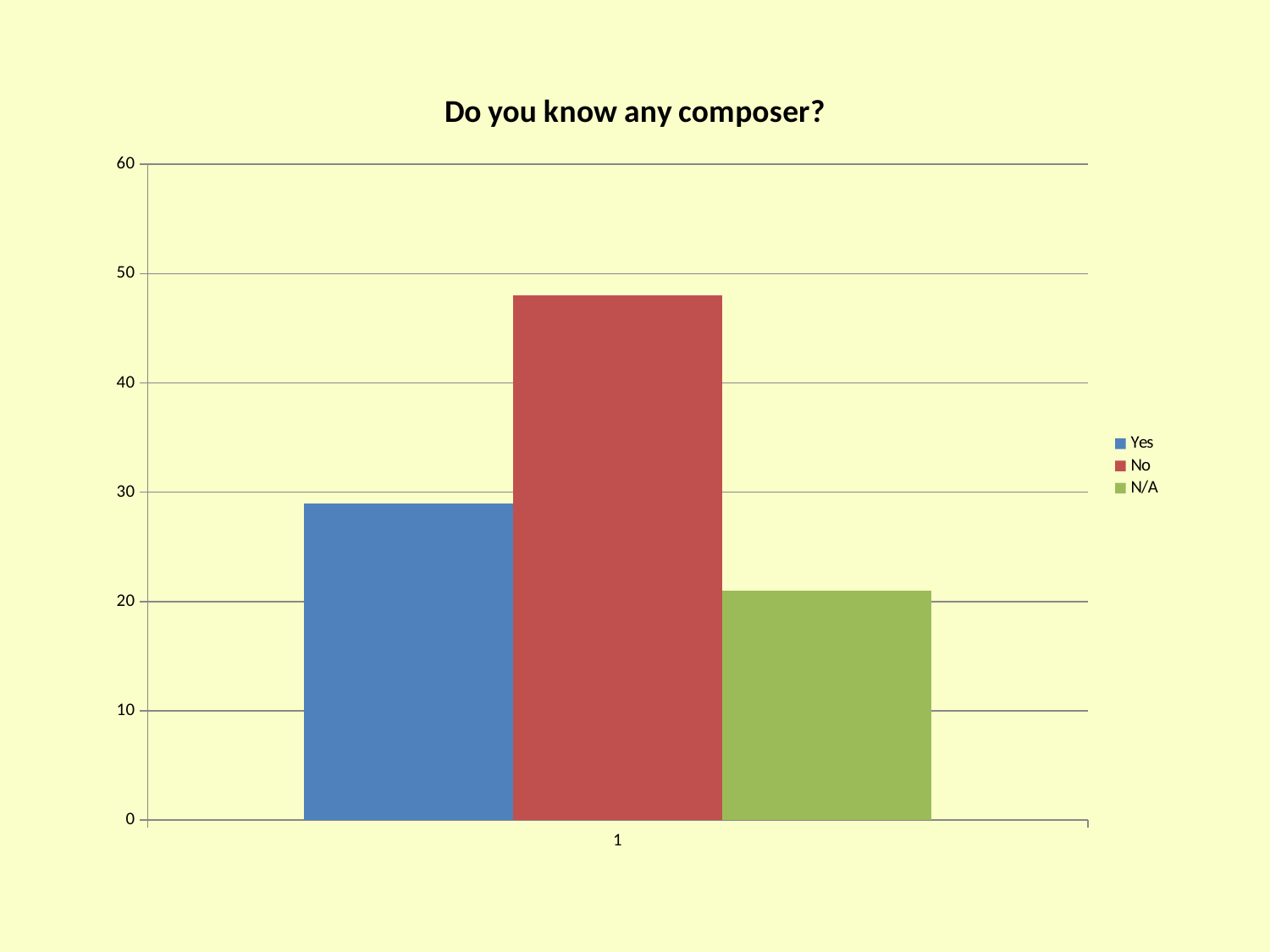
How many series does the legend list? 3 What kind of chart is shown on the slide? bar chart Which is larger, the value for No or the value for Yes? No Is the value for No greater or less than 50? less Which series has the lowest bar? N/A Is the value for N/A greater or less than 30? less What is the title of the chart? Do you know any composer? Which is larger, the value for Yes or the value for N/A? Yes What colour is the bar for the No series? red Is the value for Yes greater or less than 20? greater Which series has the highest bar? No